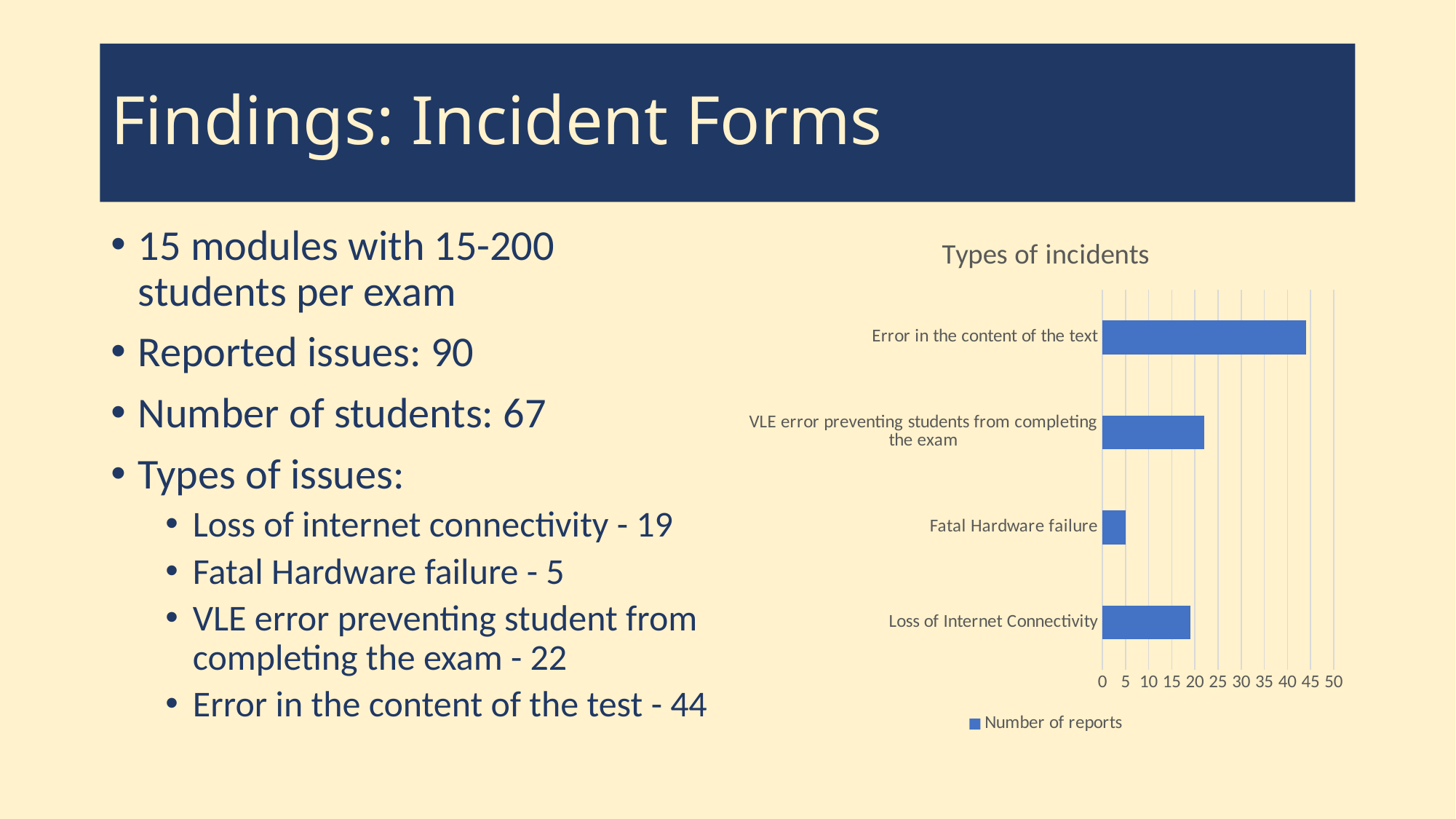
How many series does the chart legend list? 1 Is the value for VLE error preventing students from completing the exam greater or less than 25? less Is the value for Loss of Internet Connectivity greater or less than 15? greater Which has more reports: Error in the content of the text or VLE error preventing students from completing the exam? Error in the content of the text Which incident type has the lowest number of reports? Fatal Hardware failure What is the title of the chart? Types of incidents What is the number of reports for Fatal Hardware failure? 5 Is the value for Error in the content of the text greater or less than 40? greater Which incident type has the highest number of reports? Error in the content of the text What is the name of the series in the chart legend? Number of reports How many categories are plotted in the chart? 4 What kind of chart is shown on the slide? bar chart